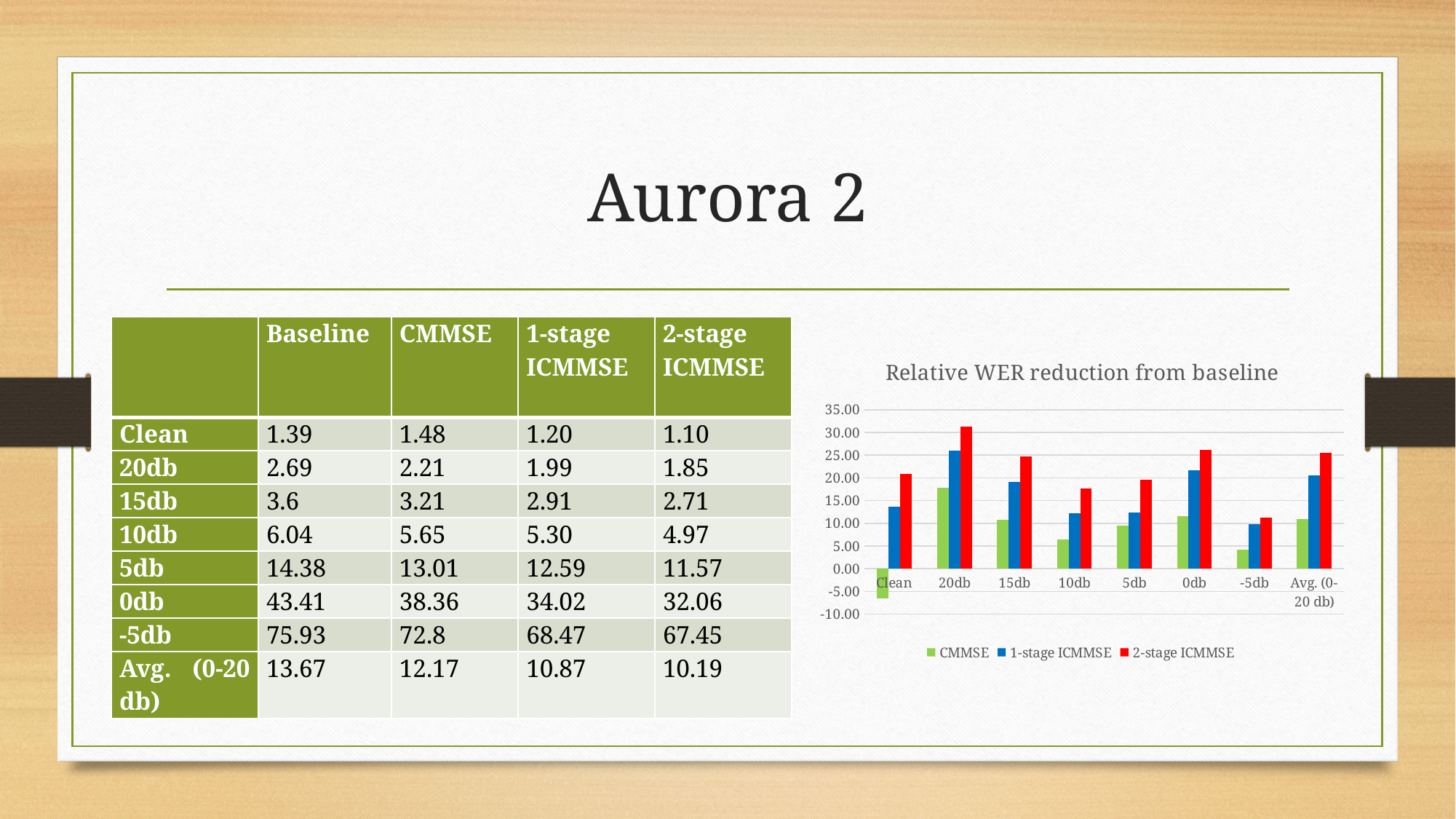
Is the 2-stage ICMMSE value for 20db greater or less than 30.00? greater Which category has the lowest 2-stage ICMMSE value in the chart? -5db Which category has the highest 2-stage ICMMSE value in the chart? 20db What kind of chart is shown on the slide? bar chart Which category has the lowest CMMSE value in the chart? Clean What is the title of the chart? Relative WER reduction from baseline Is the 2-stage ICMMSE value for -5db greater or less than 15.00? less How many categories are shown on the x axis of the chart? 8 At 0db, which is larger: the 1-stage ICMMSE value or the 2-stage ICMMSE value? 2-stage ICMMSE Which is larger: the CMMSE value for 20db or the CMMSE value for 15db? 20db How many series does the legend of the chart list? 3 Is the CMMSE value for Clean greater or less than 0.00? less